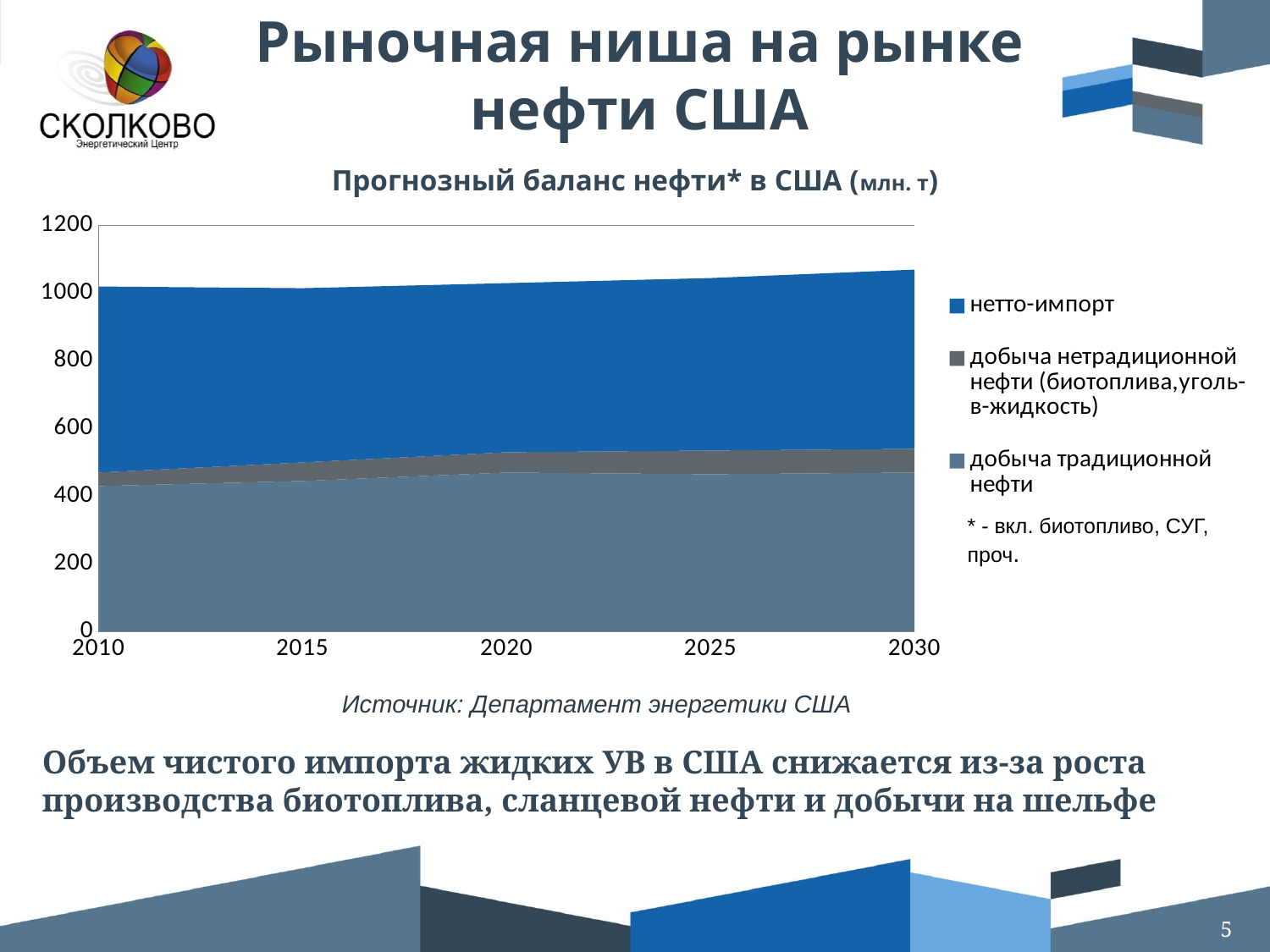
Is the value for добыча нетрадиционной нефти in 2030 greater or less than 200? less Which series occupies the smallest band in the chart? добыча нетрадиционной нефти (биотоплива, уголь-в-жидкость) Is the total of all series in 2010 greater or less than 1200? less How many series does the legend list? 3 What kind of chart is shown on the slide? Stacked area chart Is the value for добыча традиционной нефти in 2010 greater or less than 600? less Does the total of all series rise or fall from 2010 to 2030? rise How many year labels are shown on the x axis? 5 Does the value for добыча традиционной нефти rise or fall from 2010 to 2030? rise What is the title of the chart? Прогнозный баланс нефти* в США (млн. т) What source is cited below the chart? Департамент энергетики США